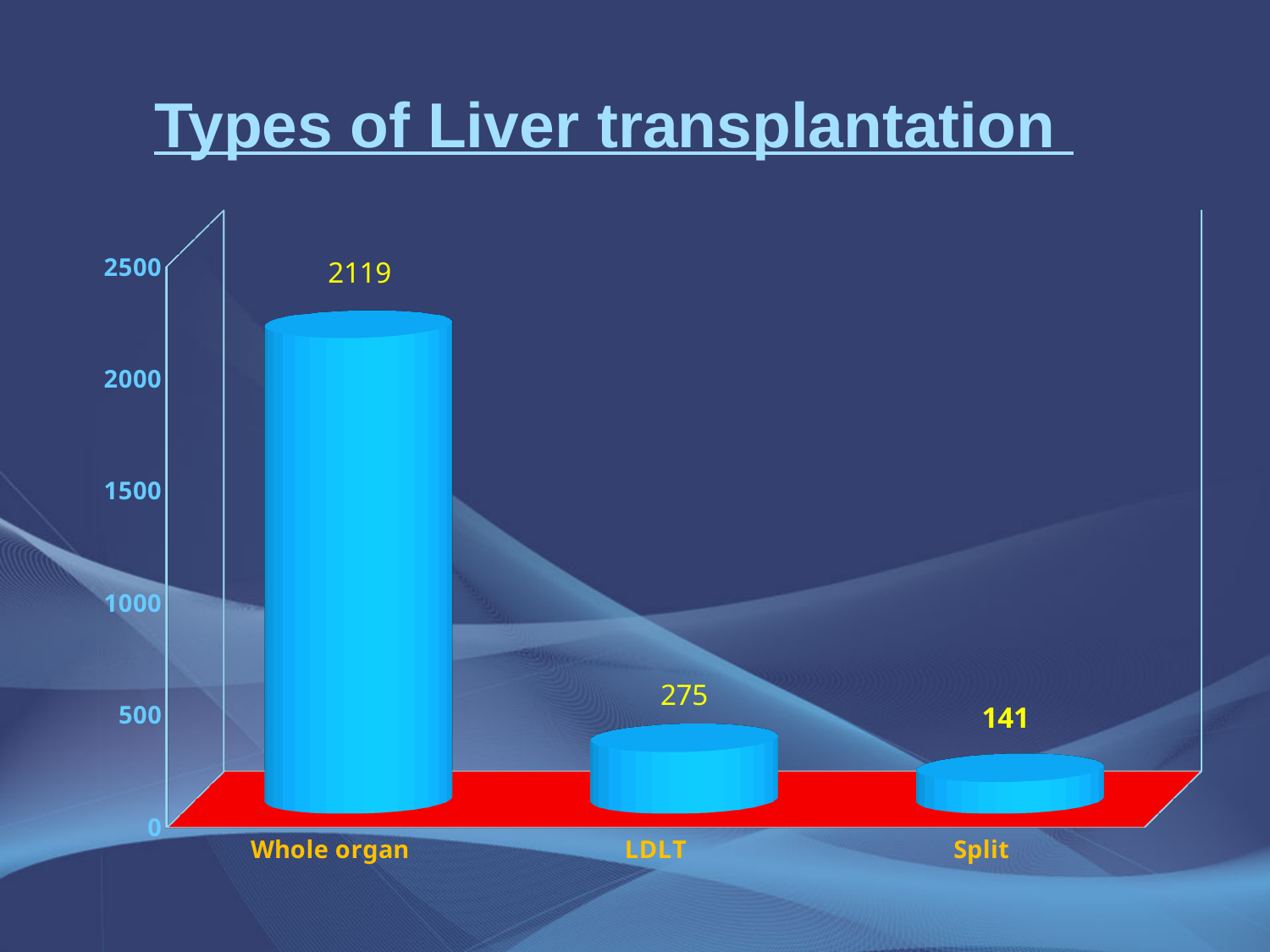
Which is larger, the value for LDLT or the value for Split? LDLT What is the title of the slide? Types of Liver transplantation How many categories are shown on the chart? 3 Which category has the lowest value? Split What is the difference between the values for LDLT and Split? 134 What is the value for LDLT? 275 Is the value for Whole organ greater or less than 2000? greater What is the value for Whole organ? 2119 What is the difference between the values for Whole organ and LDLT? 1844 What kind of chart is shown on the slide? bar chart What is the value for Split? 141 Which category has the highest value? Whole organ